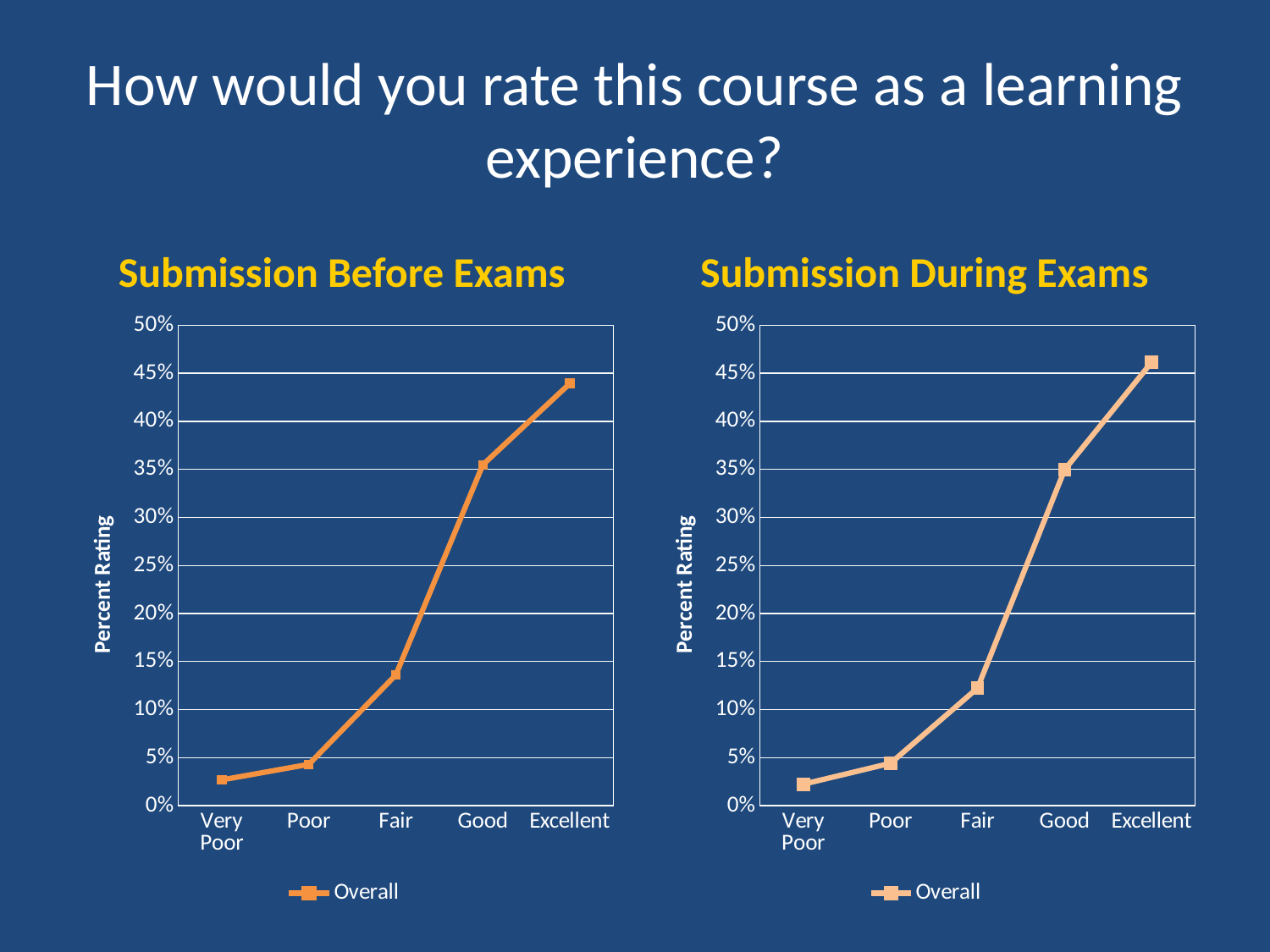
In the 'Submission During Exams' chart, do the values rise or fall from Very Poor to Excellent? rise How many categories are shown on the x axis of the 'Submission During Exams' chart? 5 What kind of chart is the 'Submission Before Exams' chart? line chart What is the name of the series shown in the legend of the 'Submission During Exams' chart? Overall How many series does the legend of the 'Submission Before Exams' chart list? 1 In the 'Submission Before Exams' chart, is the value for Excellent greater or less than 40%? greater In the 'Submission During Exams' chart, which rating category has the lowest value? Very Poor In the 'Submission During Exams' chart, is the value for Fair greater or less than 15%? less In the 'Submission Before Exams' chart, which rating category has the highest value? Excellent In the 'Submission Before Exams' chart, which is larger, the value for Good or the value for Fair? Good What is the y-axis title of the 'Submission Before Exams' chart? Percent Rating In the 'Submission During Exams' chart, is the value for Excellent greater or less than 45%? greater